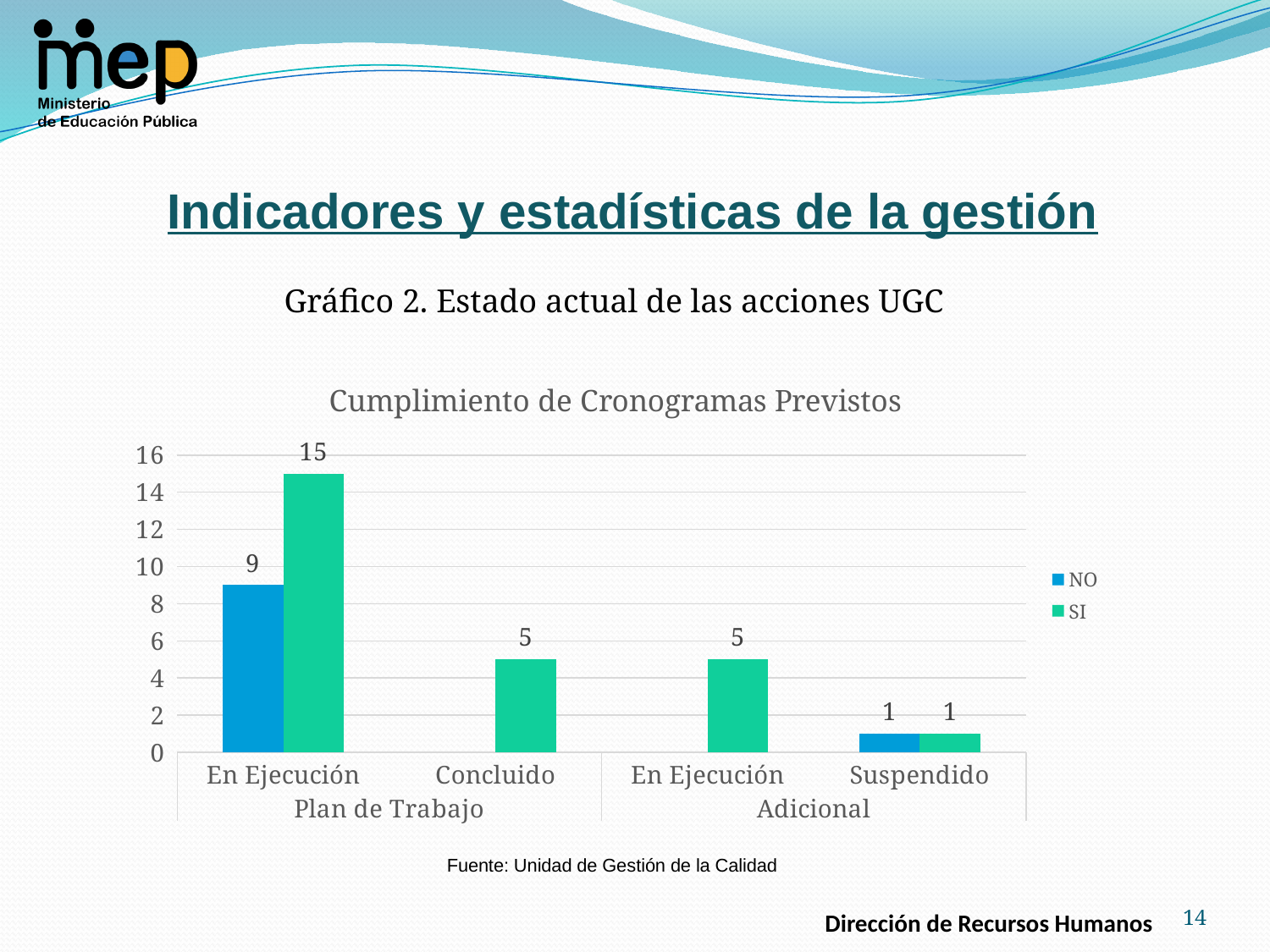
How many series does the legend list? 2 What is the title of the chart? Cumplimiento de Cronogramas Previstos Which category has the highest SI value? En Ejecución (Plan de Trabajo) What is the NO value for Suspendido? 1 What is the difference between the SI and NO values for En Ejecución under Plan de Trabajo? 6 What is the SI value for Concluido? 5 What is the SI value for En Ejecución under Plan de Trabajo? 15 Which is larger for En Ejecución under Plan de Trabajo, the NO value or the SI value? SI What is the NO value for En Ejecución under Plan de Trabajo? 9 What is the SI value for En Ejecución under Adicional? 5 How many categories are shown on the x axis? 4 What type of chart is shown on the slide? Bar chart